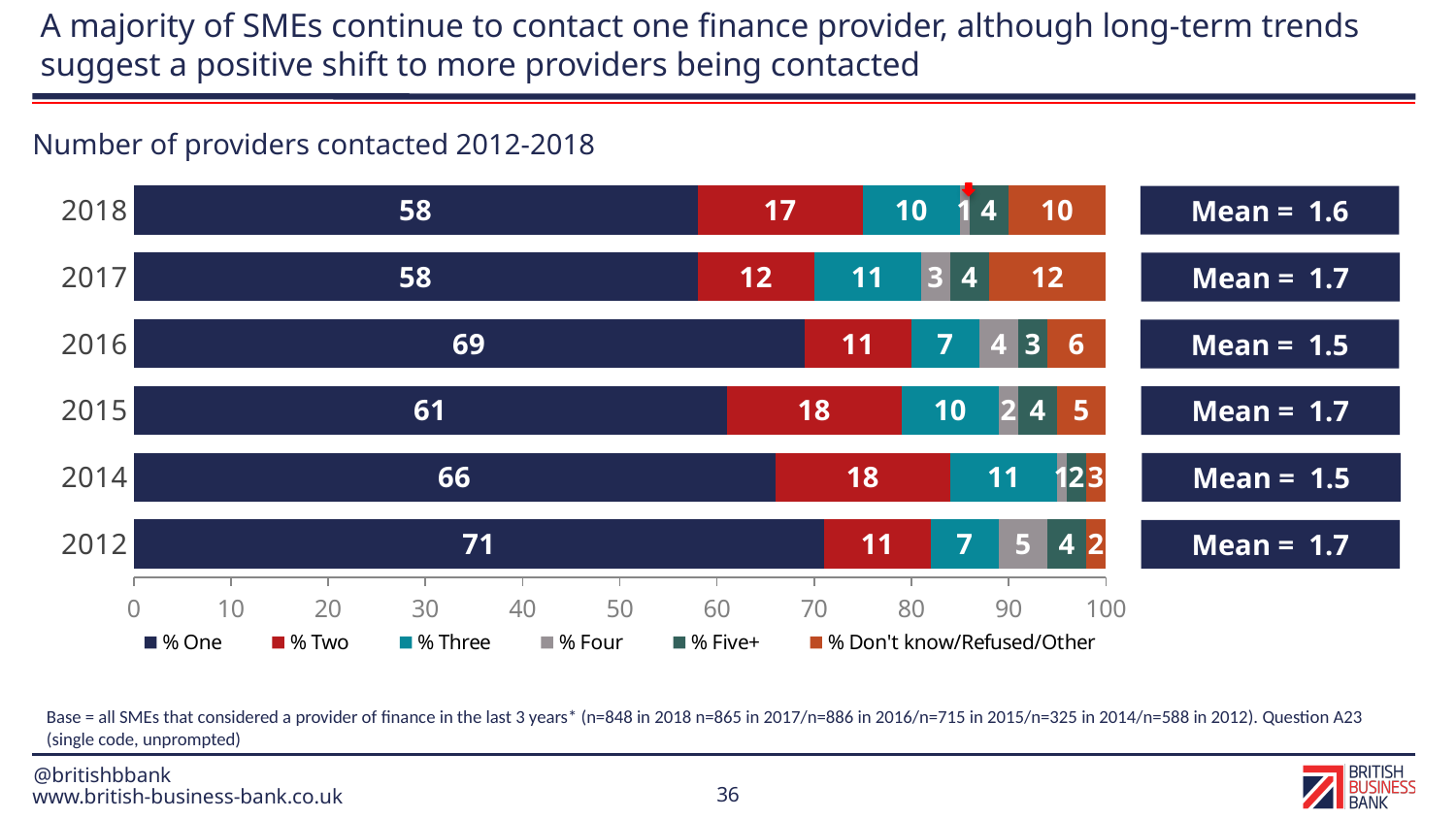
What is the value for % Four in 2012? 5 What is the value for % Two in 2015? 18 What is the difference between the % Three value in 2017 and in 2016? 4 What is the value for % One in 2018? 58 Which year has the highest value for % One? 2012 What is the value for % Don't know/Refused/Other in 2017? 12 How many years are shown on the chart? 6 Which year has the lowest value for % Don't know/Refused/Other? 2012 Which year has the larger value for % Two, 2018 or 2017? 2018 What is the difference between the % One value in 2012 and in 2018? 13 What kind of chart is shown on the slide? Stacked bar chart How many series does the legend list? 6